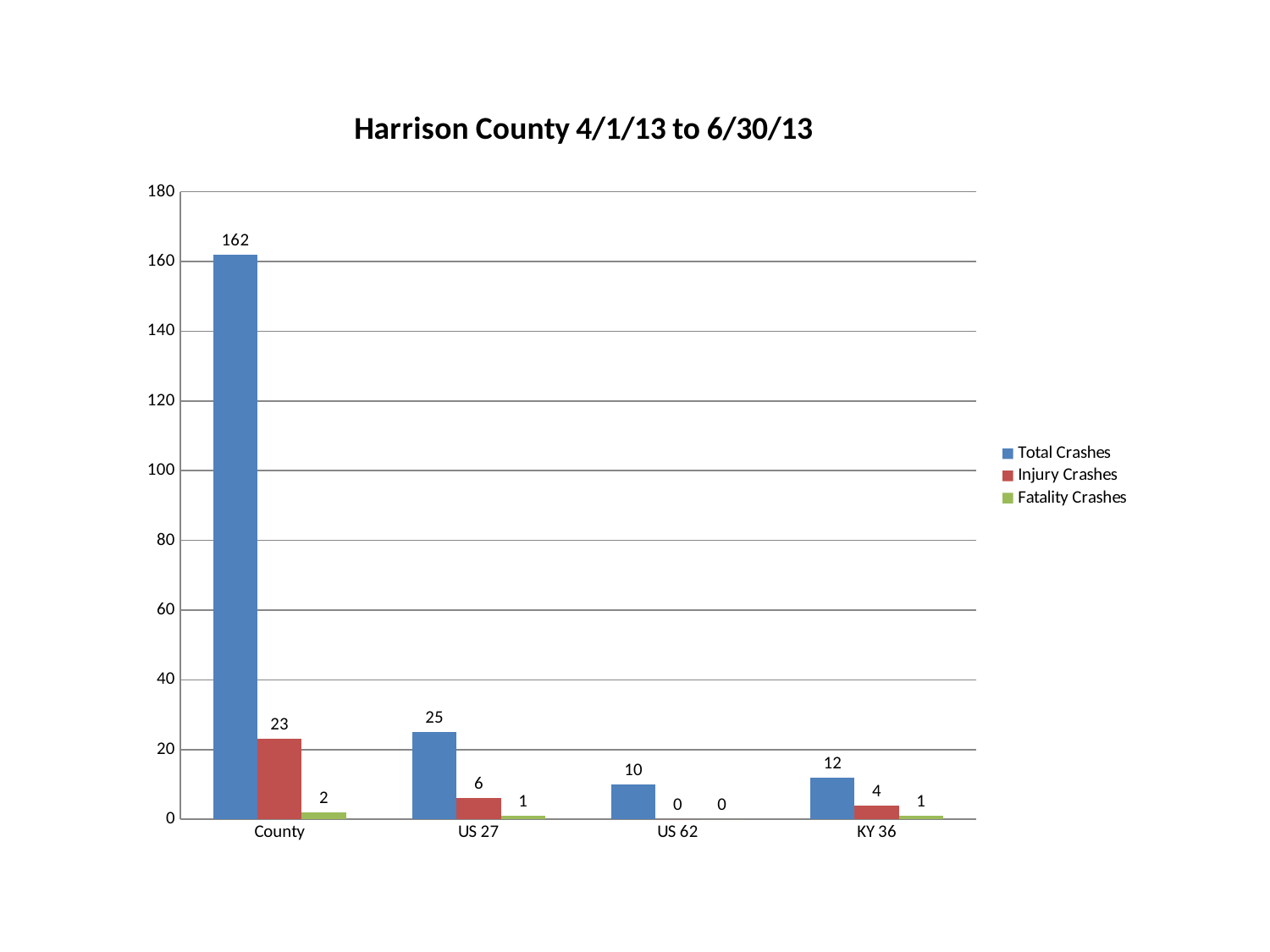
What kind of chart is shown on the slide? bar chart How many categories are shown on the x axis? 4 How many series does the legend list? 3 Which is larger, Injury Crashes for County or Injury Crashes for US 27? Injury Crashes for County Which category has the highest Total Crashes? County What is the title of the chart? Harrison County 4/1/13 to 6/30/13 What is the difference between Total Crashes for US 27 and Total Crashes for KY 36? 13 Is the value of Total Crashes for County greater or less than 140? greater What is the value of Total Crashes for County? 162 What is the value of Fatality Crashes for KY 36? 1 Which category has the lowest Total Crashes? US 62 What is the value of Injury Crashes for US 27? 6